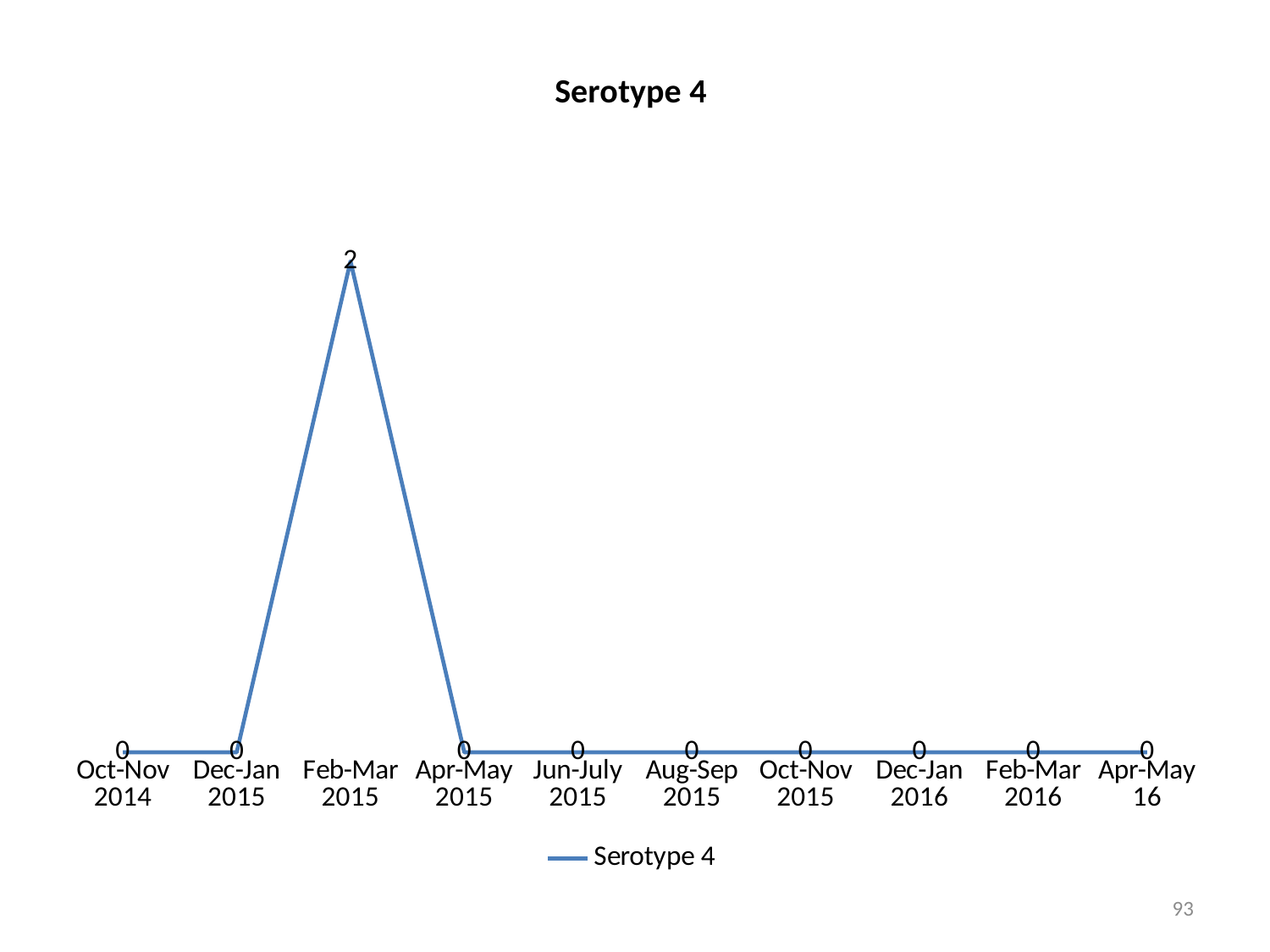
How many series does the legend list? 1 Which is larger, the value for Feb-Mar 2015 or the value for Aug-Sep 2015? Feb-Mar 2015 What is the value for Apr-May 16? 0 What kind of chart is this? line chart What series name is shown in the legend? Serotype 4 What is the title of the chart? Serotype 4 How many periods are plotted on the x axis? 10 What is the value for Feb-Mar 2015? 2 Which period has the highest value? Feb-Mar 2015 Does the value rise or fall from Feb-Mar 2015 to Apr-May 2015? fall What is the value for Oct-Nov 2014? 0 What is the difference between the values for Feb-Mar 2015 and Dec-Jan 2015? 2